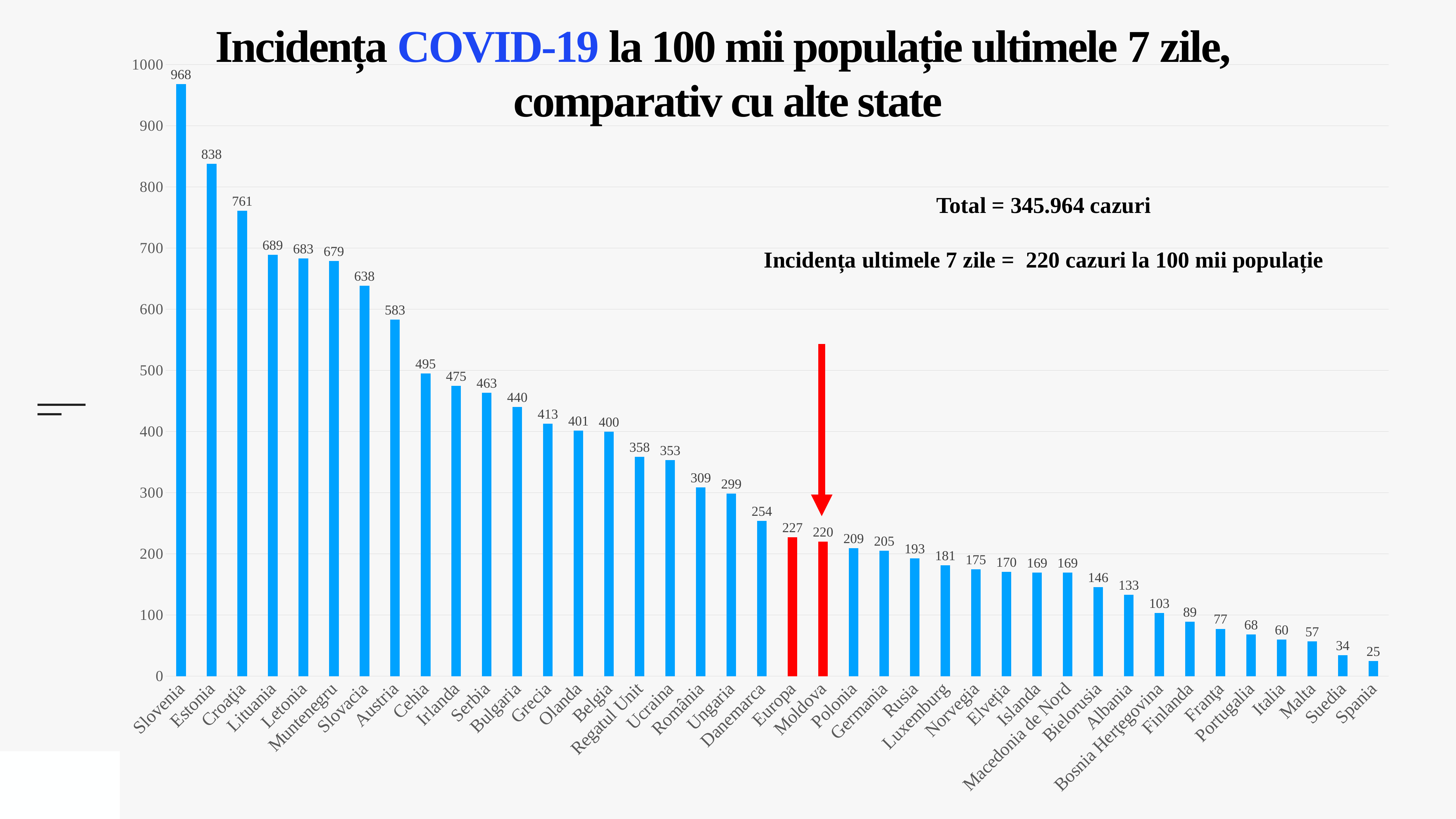
What is the difference between the values for Estonia and Croația? 77 What is the value for Slovenia? 968 Do the values rise or fall from left to right along the x axis? Fall Which two bars are coloured red instead of blue? Europa and Moldova What is the value for Germania? 205 What is the value for Moldova? 220 Which country has the lowest value? Spania Which is larger, the value for România or the value for Ungaria? România What kind of chart is shown on the slide? Bar chart Which country has the highest value? Slovenia How many countries/categories are shown on the x axis? 40 What is the difference between the values for Europa and Moldova? 7